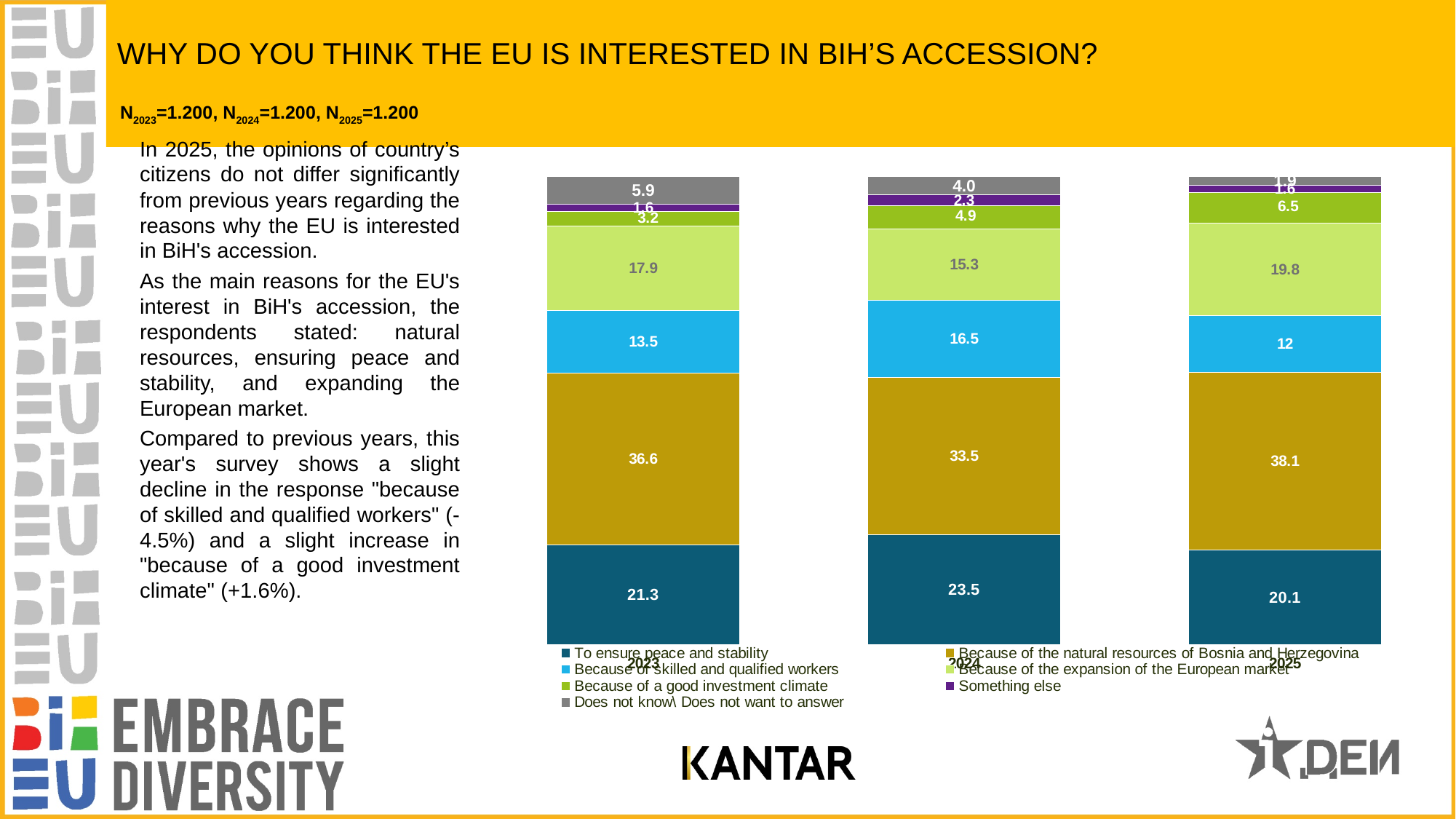
In which year is the value for 'Because of the natural resources of Bosnia and Herzegovina' the highest? 2025 What is the value for 'Because of skilled and qualified workers' in 2023? 13.5 How many years are shown on the x axis of the chart? 3 What kind of chart is shown on the slide? Stacked bar chart What is the value for 'Because of the natural resources of Bosnia and Herzegovina' in 2024? 33.5 Which year has the larger value for 'To ensure peace and stability', 2023 or 2024? 2024 What is the value for 'Does not know\ Does not want to answer' in 2023? 5.9 In which year is the value for 'Because of the expansion of the European market' the lowest? 2024 Does the value for 'Because of a good investment climate' rise or fall from 2023 to 2025? Rise What is the value for 'To ensure peace and stability' in 2025? 20.1 What is the difference between the 2024 and 2025 values for 'Because of skilled and qualified workers'? 4.5 How many series does the legend list? 7